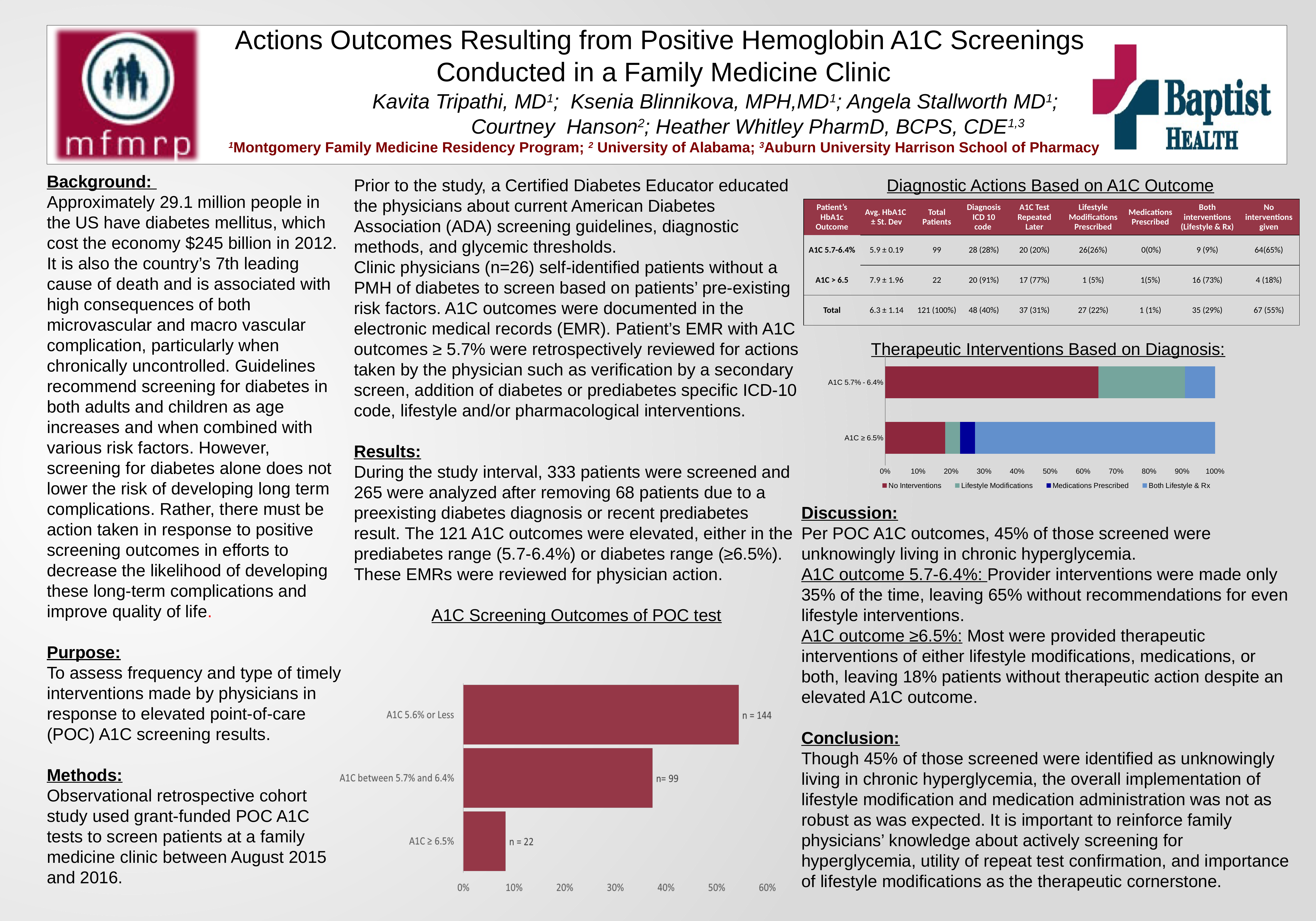
What kind of chart is 'Therapeutic Interventions Based on Diagnosis'? Stacked bar chart How many categories are shown in the 'A1C Screening Outcomes of POC test' chart? 3 In the 'Therapeutic Interventions Based on Diagnosis' chart, which category has the larger No Interventions segment, A1C 5.7% - 6.4% or A1C ≥ 6.5%? A1C 5.7% - 6.4% In the 'A1C Screening Outcomes of POC test' chart, what is the difference in n between A1C 5.6% or Less and A1C ≥ 6.5%? 122 How many series does the legend of the 'Therapeutic Interventions Based on Diagnosis' chart list? 4 In the 'A1C Screening Outcomes of POC test' chart, what is the data label for A1C ≥ 6.5%? n = 22 In the 'A1C Screening Outcomes of POC test' chart, what is the data label for A1C 5.6% or Less? n = 144 In the 'A1C Screening Outcomes of POC test' chart, which category has the smallest bar? A1C ≥ 6.5% In the 'A1C Screening Outcomes of POC test' chart, what is the data label for A1C between 5.7% and 6.4%? n= 99 In the 'A1C Screening Outcomes of POC test' chart, is the bar for A1C ≥ 6.5% greater or less than 10%? less In the 'A1C Screening Outcomes of POC test' chart, which category has the largest bar? A1C 5.6% or Less In the 'A1C Screening Outcomes of POC test' chart, is the bar for A1C 5.6% or Less greater or less than 50%? greater